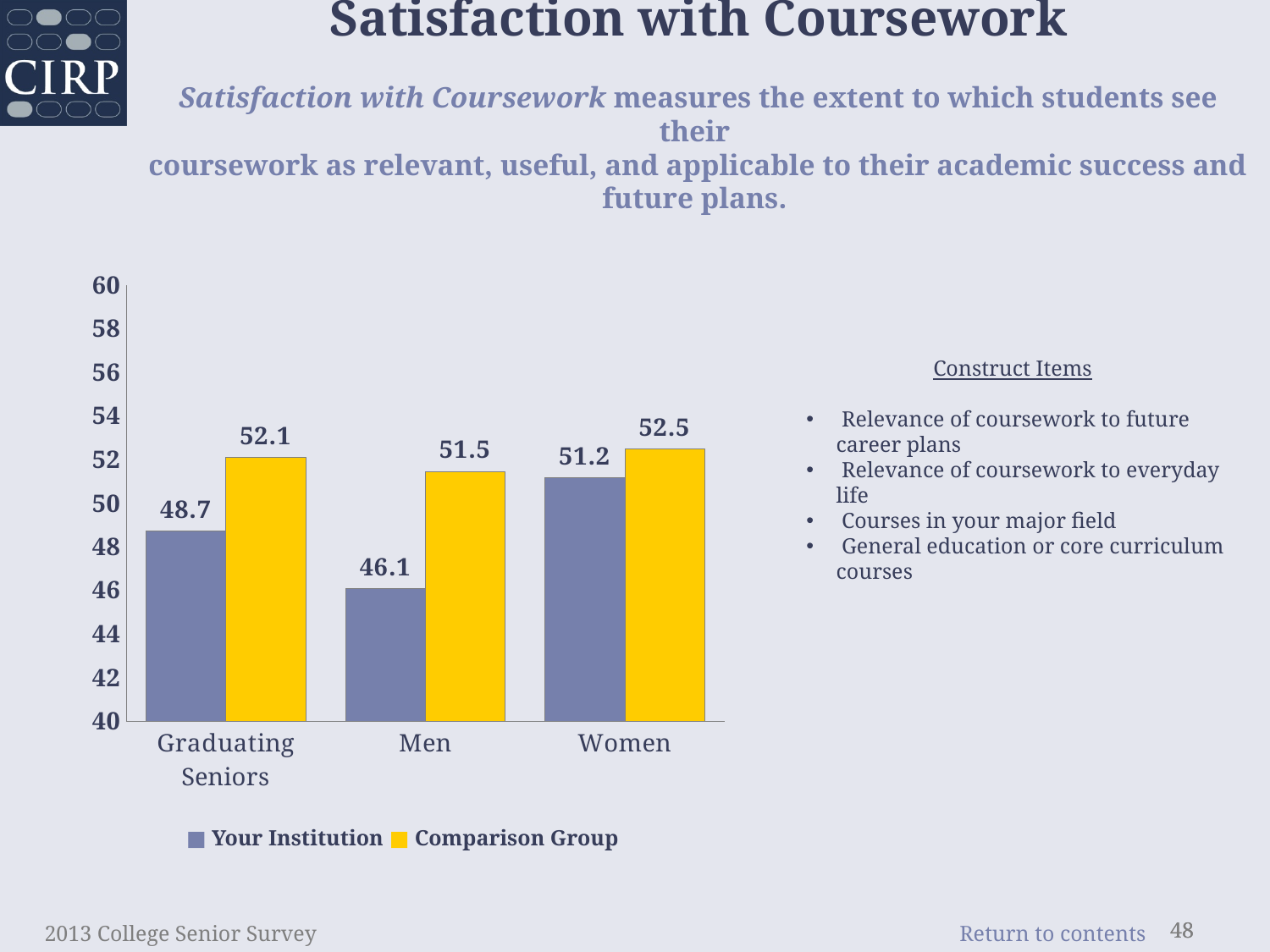
What is the difference between the Comparison Group and Your Institution values for Men? 5.4 How many categories are shown on the x axis? 3 What kind of chart is shown on the slide? bar chart What is the Your Institution value for Graduating Seniors? 48.7 How many series does the legend list? 2 Is the Your Institution value for Men greater or less than 48? less Which is larger for Women: Your Institution or Comparison Group? Comparison Group Which category has the highest Comparison Group value? Women What is the Your Institution value for Women? 51.2 What is the difference between the Comparison Group and Your Institution values for Graduating Seniors? 3.4 What is the Comparison Group value for Men? 51.5 Which category has the lowest Your Institution value? Men